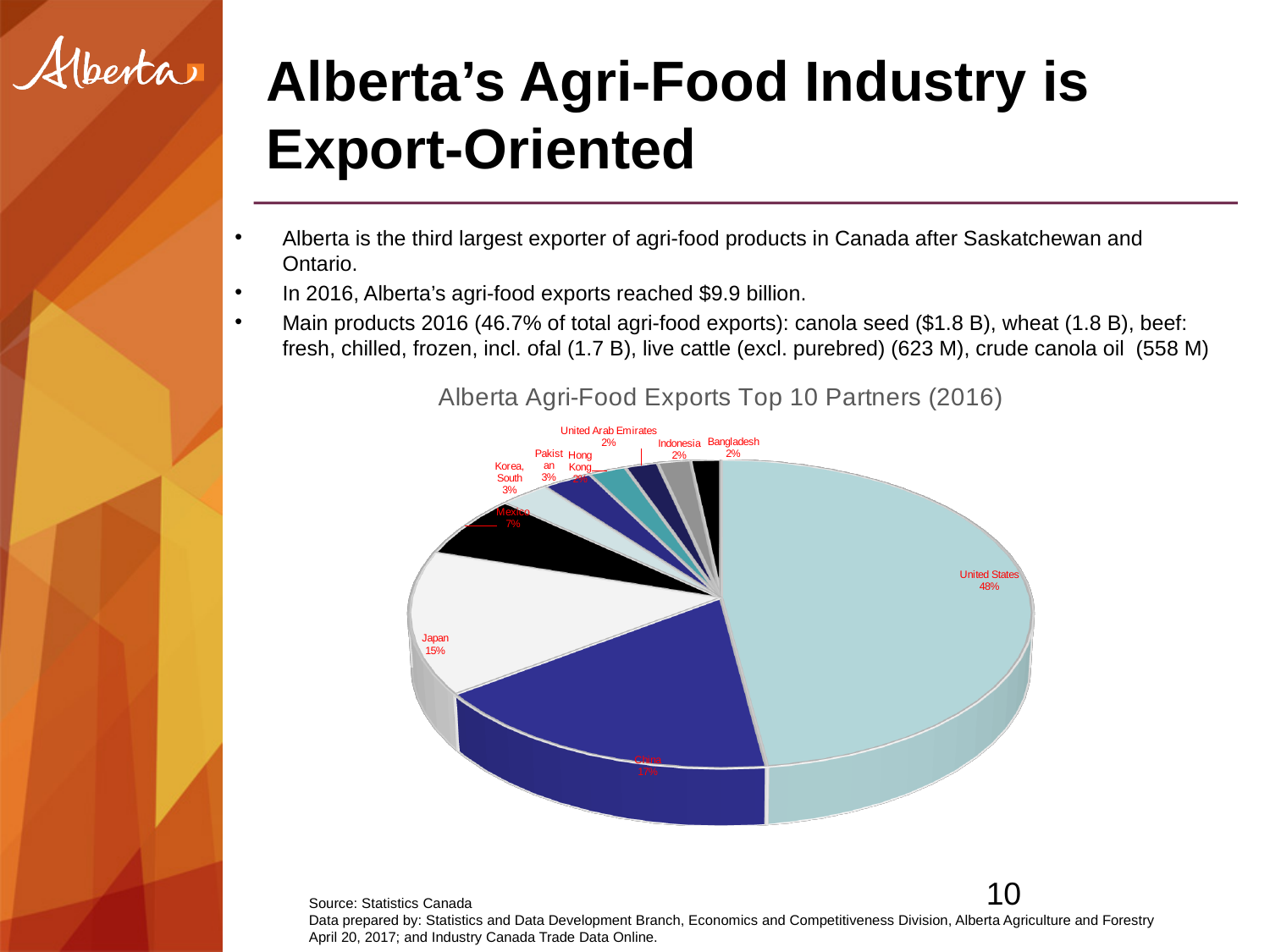
What share of Alberta's agri-food exports went to Korea, South? 3% What is the title of the chart? Alberta Agri-Food Exports Top 10 Partners (2016) What is the difference in percentage points between Japan's share and Mexico's share? 8% What is the difference in percentage points between the United States' share and Japan's share? 33% Which export partner has the largest slice of the pie? United States What share of Alberta's agri-food exports went to Mexico? 7% How many export partners are shown in the pie chart? 10 What share of Alberta's agri-food exports went to the United States? 48% What share of Alberta's agri-food exports went to Japan? 15% What share of Alberta's agri-food exports went to Bangladesh? 2% What kind of chart is shown on the slide? pie chart Which has a larger share of exports, Japan or Mexico? Japan